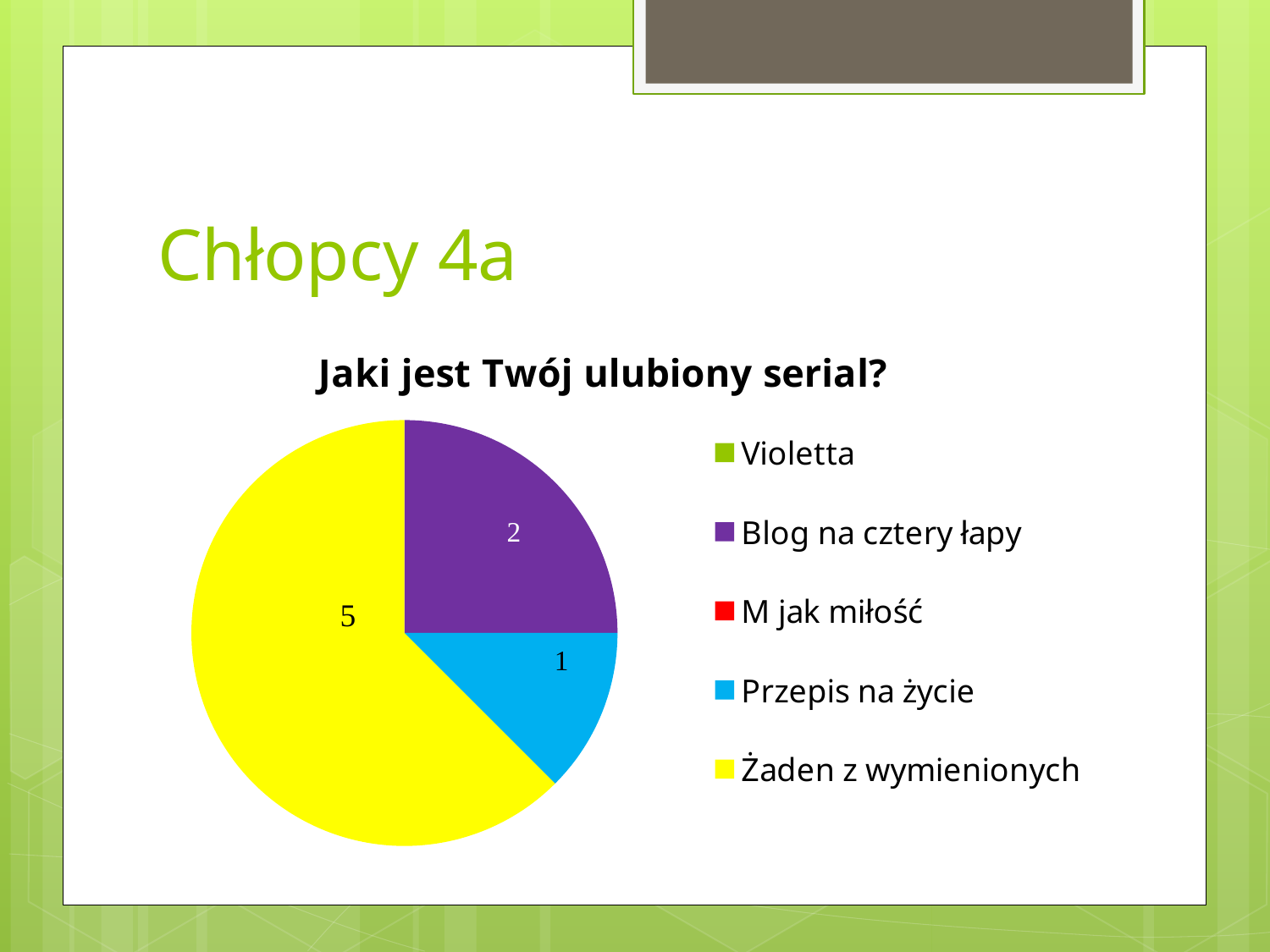
How many categories does the chart's legend list? 5 What type of chart is shown on the slide? pie chart What is the difference between the values for Żaden z wymienionych and Blog na cztery łapy? 3 Which colour represents Żaden z wymienionych in the chart? yellow What is the title of the chart? Jaki jest Twój ulubiony serial? What is the value for Żaden z wymienionych? 5 What is the value for Przepis na życie? 1 Which is larger, Blog na cztery łapy or Przepis na życie? Blog na cztery łapy What is the difference between the values for Blog na cztery łapy and Przepis na życie? 1 What is the value for Blog na cztery łapy? 2 Which category has the largest slice of the pie? Żaden z wymienionych What share of the pie does Blog na cztery łapy represent? 25%